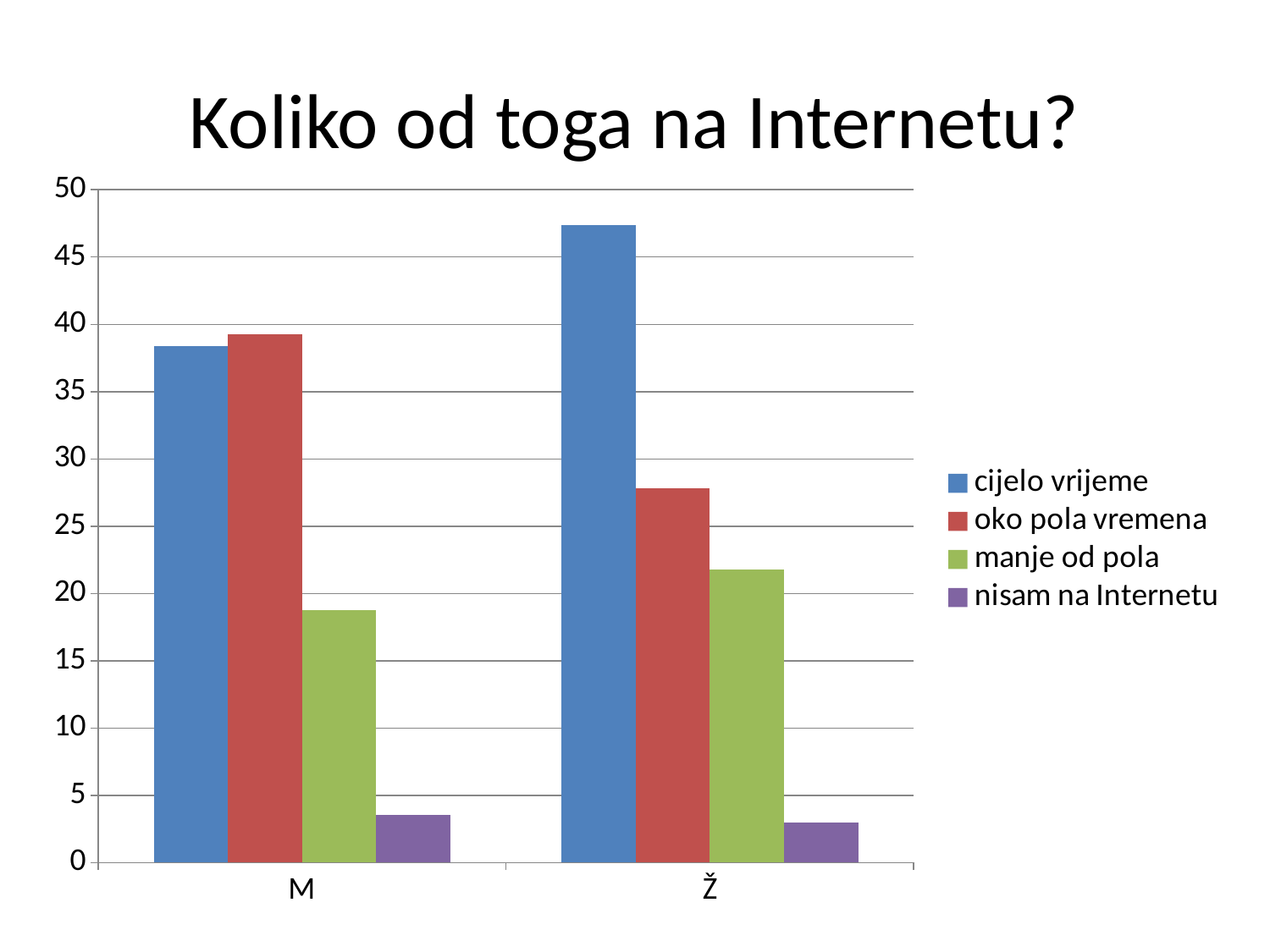
Is the value of nisam na Internetu for Ž greater or less than 5? less What is the title of the chart? Koliko od toga na Internetu? How many categories are shown on the x axis? 2 Is the value of oko pola vremena for Ž greater or less than 25? greater What kind of chart is shown on the slide? bar chart Which series has the highest value for Ž? cijelo vrijeme Which series has the lowest value for M? nisam na Internetu Which is larger: oko pola vremena for M or oko pola vremena for Ž? M How many series does the legend list? 4 Is the value of manje od pola for M greater or less than 20? less Which is larger: cijelo vrijeme for M or cijelo vrijeme for Ž? Ž